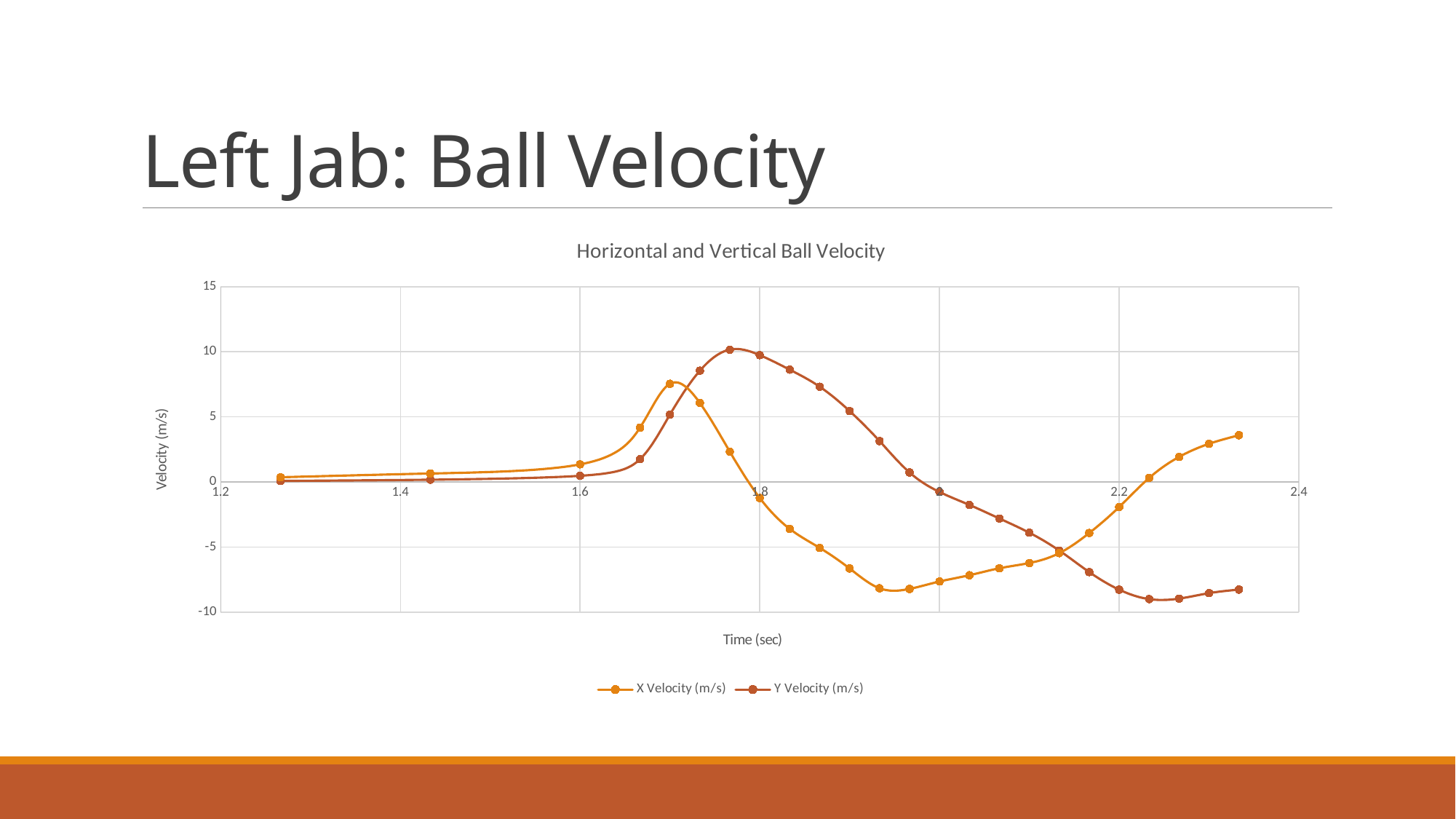
Is the lowest value of the Y Velocity (m/s) series greater or less than -5? less What is the label of the vertical axis? Velocity (m/s) Between 2.2 sec and 2.4 sec, does the X Velocity (m/s) series rise or fall? rise Is the lowest value of the X Velocity (m/s) series greater or less than -5? less At time 2.2 sec, which series has the higher value, X Velocity (m/s) or Y Velocity (m/s)? X Velocity (m/s) What is the title of the chart? Horizontal and Vertical Ball Velocity What kind of chart is shown on the slide? line chart Is the peak value of the X Velocity (m/s) series greater or less than 10? less How many series does the legend list? 2 At time 1.8 sec, which series has the higher value, X Velocity (m/s) or Y Velocity (m/s)? Y Velocity (m/s) Between 1.8 sec and 2.2 sec, does the Y Velocity (m/s) series rise or fall? fall